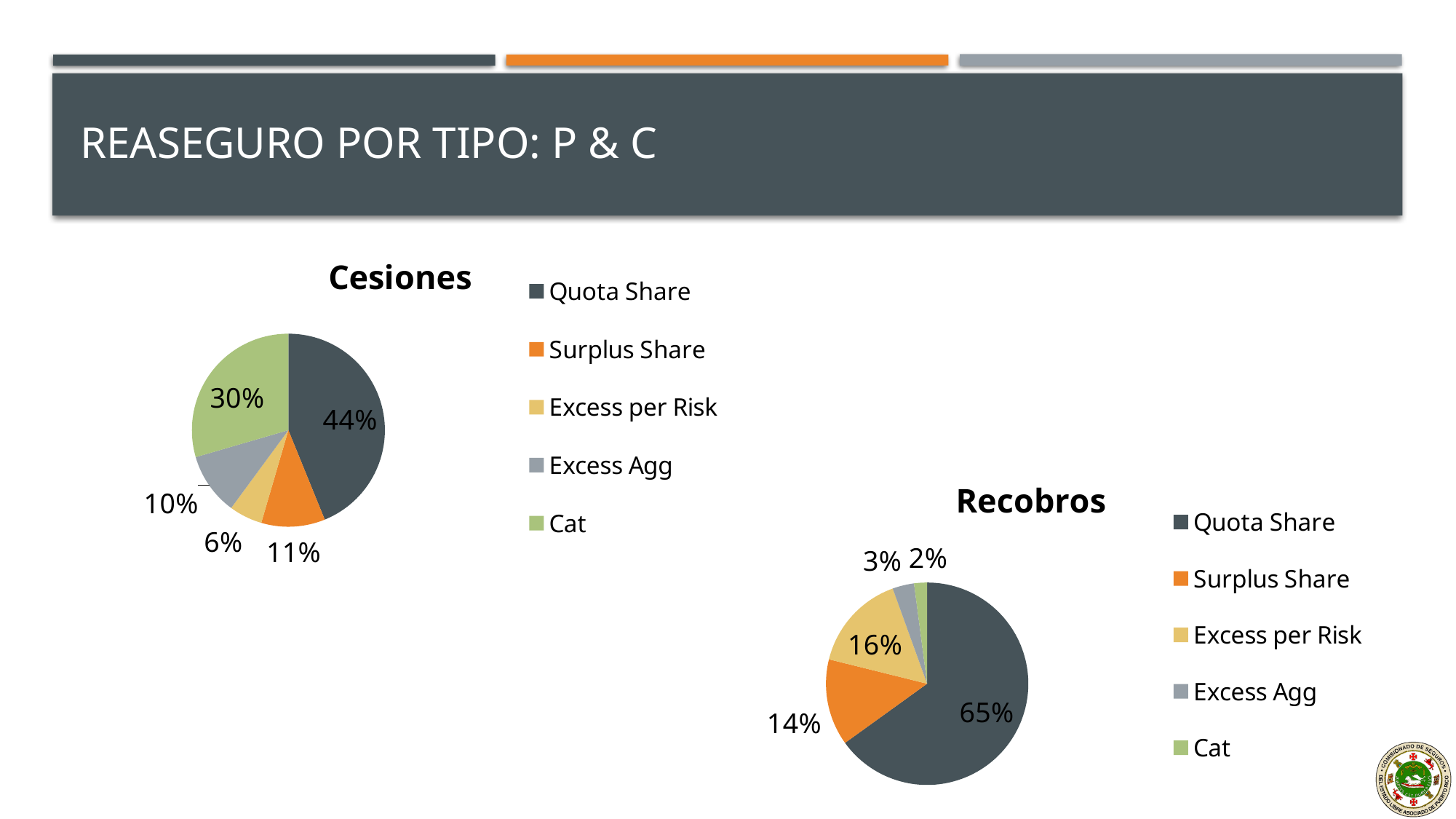
In the Cesiones chart, what is the difference between the Quota Share and Cat slices? 14% In the Recobros chart, which category has the largest slice? Quota Share In the Recobros chart, which category has the smallest slice? Cat In the Recobros chart, what share does Quota Share have? 65% In the Cesiones chart, which category has the smallest slice? Excess per Risk In the Recobros chart, what share does Excess per Risk have? 16% In the Cesiones chart, what share does Cat have? 30% In the Recobros chart, which is larger: Surplus Share or Excess per Risk? Excess per Risk How many categories does the Cesiones chart show? 5 In the Recobros chart, what is the difference between the Quota Share and Surplus Share slices? 51% In the Cesiones chart, what share does Quota Share have? 44% What type of chart is the Recobros chart? Pie chart